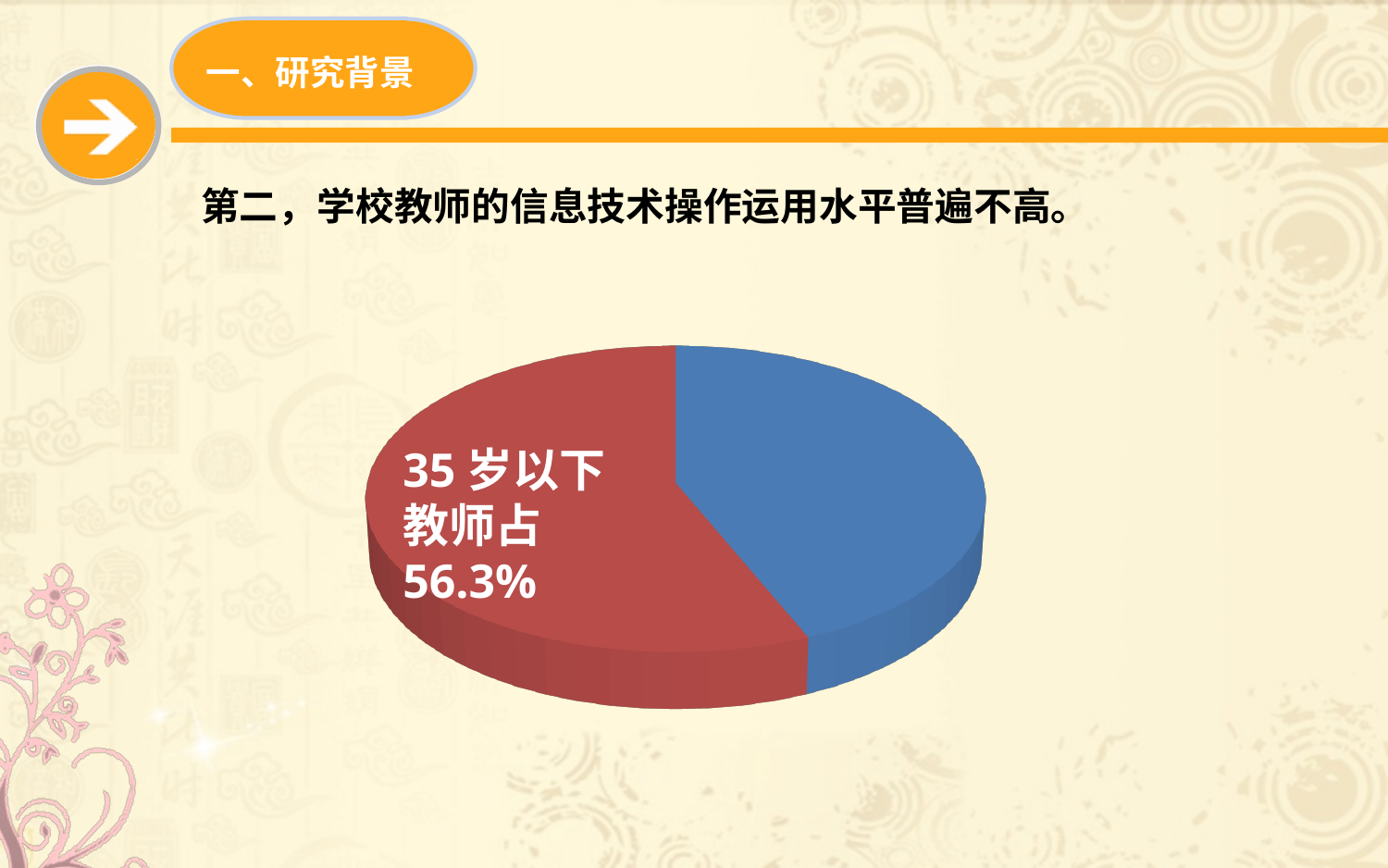
What share of the pie does the slice labeled 35 岁以下教师 represent? 56.3% Is the share of the red slice greater or less than 50%? greater What colour is the unlabeled slice of the pie chart? blue Is the share of the blue slice greater or less than 50%? less What percentage of teachers are under 35 years old (35 岁以下教师) according to the pie chart? 56.3% What kind of chart is shown on the slide? pie chart Which slice of the pie chart is larger, the red one or the blue one? red What colour is the slice labeled 35 岁以下教师占 56.3%? red How many slices does the pie chart have? 2 Which category takes up the largest portion of the pie chart? 35 岁以下教师